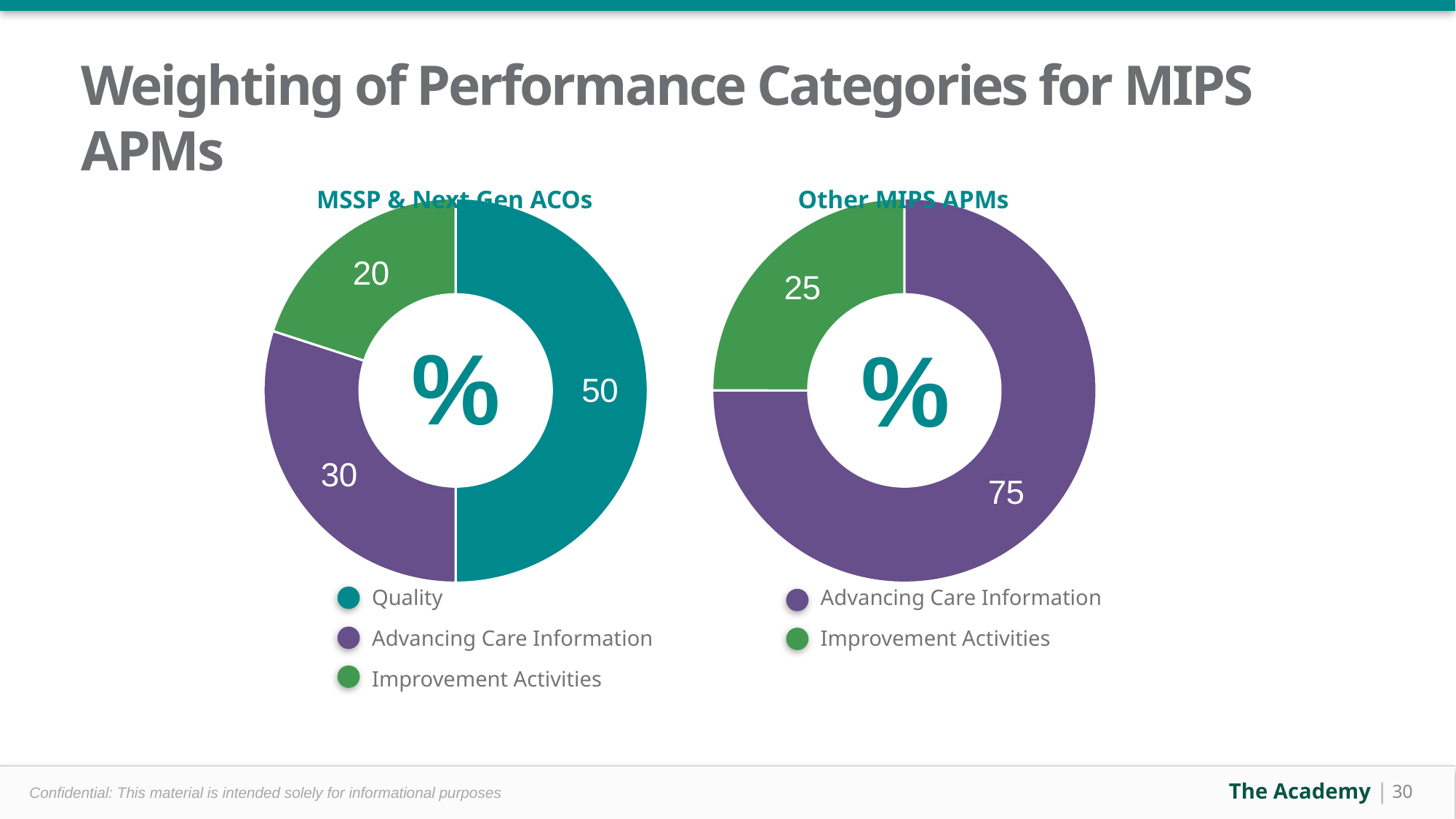
In the MSSP & Next Gen ACOs chart, what is the value for Quality? 50 How many categories does the MSSP & Next Gen ACOs chart show? 3 In the Other MIPS APMs chart, what is the value for Advancing Care Information? 75 In the Other MIPS APMs chart, what is the difference between the Advancing Care Information value and the Improvement Activities value? 50 In the Other MIPS APMs chart, which category has the largest share? Advancing Care Information In the MSSP & Next Gen ACOs chart, what is the value for Advancing Care Information? 30 In the MSSP & Next Gen ACOs chart, which category has the largest share? Quality In the Other MIPS APMs chart, what is the value for Improvement Activities? 25 What kind of chart is the Other MIPS APMs chart? Doughnut chart In the MSSP & Next Gen ACOs chart, what is the value for Improvement Activities? 20 In the MSSP & Next Gen ACOs chart, which category has the smallest share? Improvement Activities In the MSSP & Next Gen ACOs chart, what is the difference between the Quality value and the Advancing Care Information value? 20